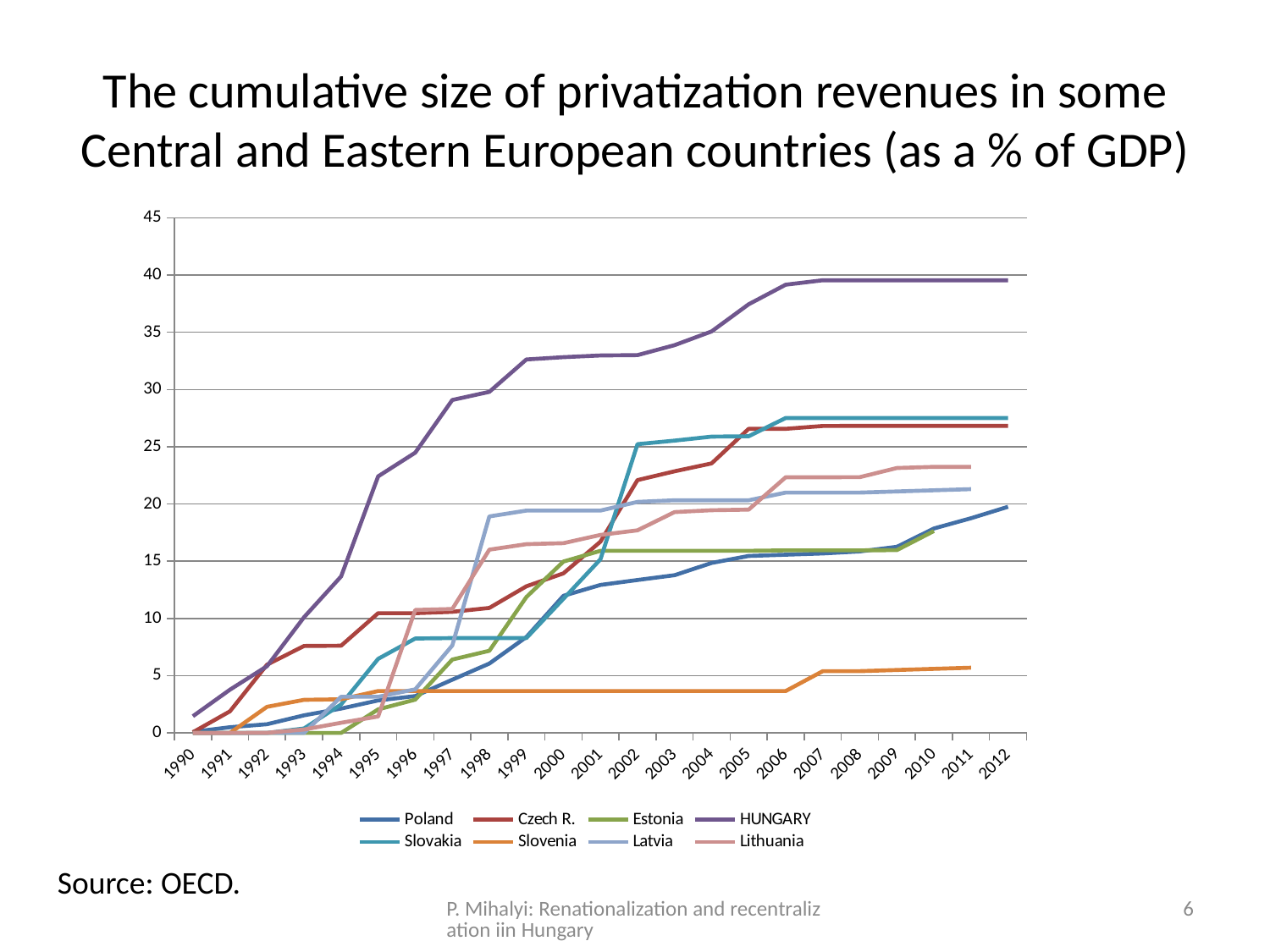
In 2012, which is larger, the value for HUNGARY or the value for Czech R.? HUNGARY Is the value for Poland in 2012 greater or less than 15? greater Which country has the highest cumulative privatization revenue in 2012? HUNGARY Does the HUNGARY line rise or fall from 1990 to 2012? rise Is the value for HUNGARY in 2012 greater or less than 35? greater What is the source cited for the chart data? OECD Which country has the highest value in 1995? HUNGARY Which country has the lowest cumulative privatization revenue in 2012? Poland How many years are shown along the x axis? 23 What type of chart is shown on the slide? line chart How many series does the legend list? 8